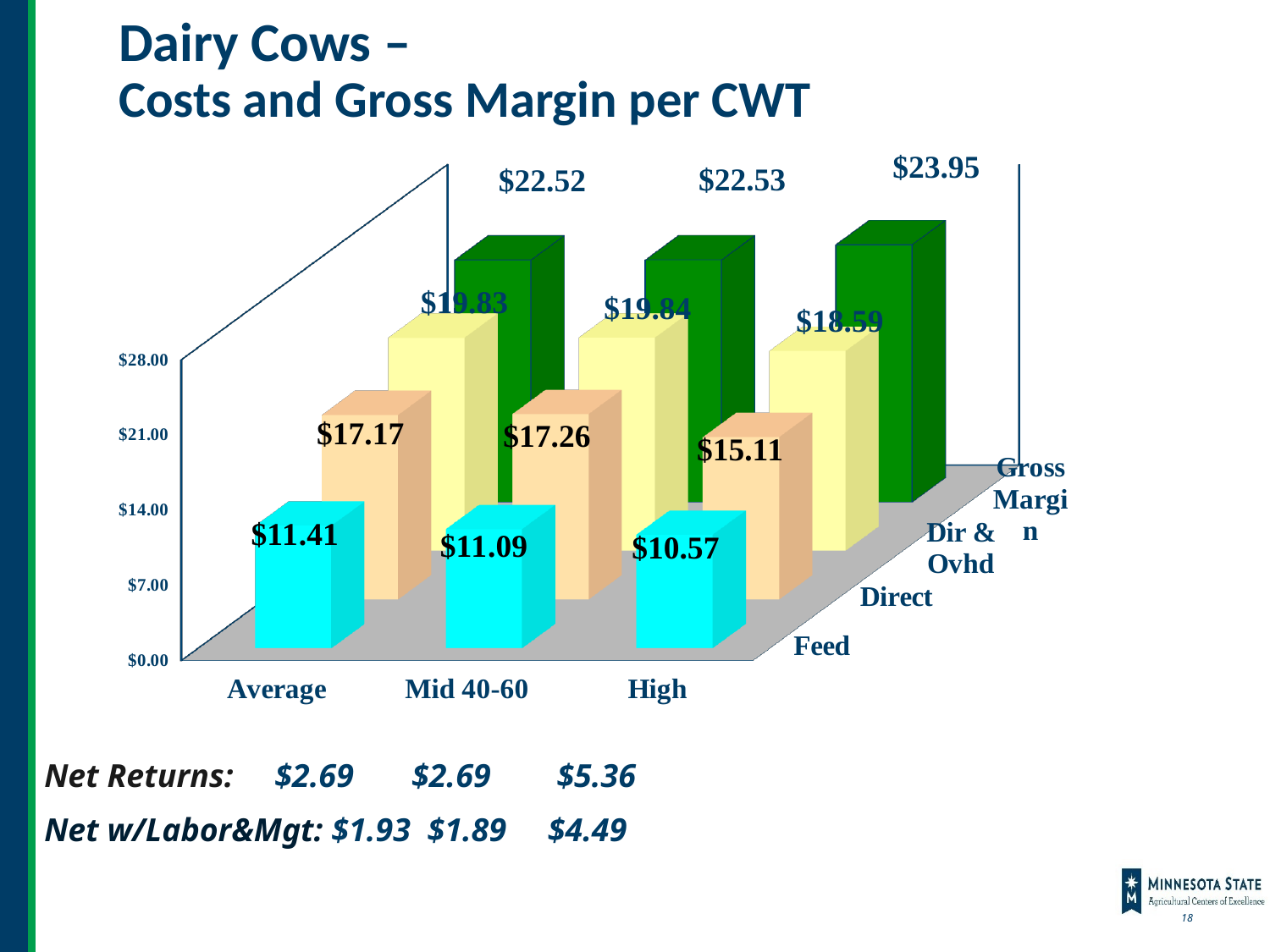
Which group has the highest Gross Margin value? High What is the Direct value for the Mid 40-60 group? $17.26 What is the Feed value for the Average group? $11.41 How many series are plotted in the chart? 4 What is the Gross Margin value for the High group? $23.95 What kind of chart is shown on the slide? Bar chart How many groups are shown on the x axis? 3 Which is larger, the Feed value for Average or the Feed value for Mid 40-60? Average What is the title of the slide? Dairy Cows – Costs and Gross Margin per CWT What is the Dir & Ovhd value for the High group? $18.59 Which group has the lowest Feed value? High What is the difference between the Direct values for Average and High? $2.06